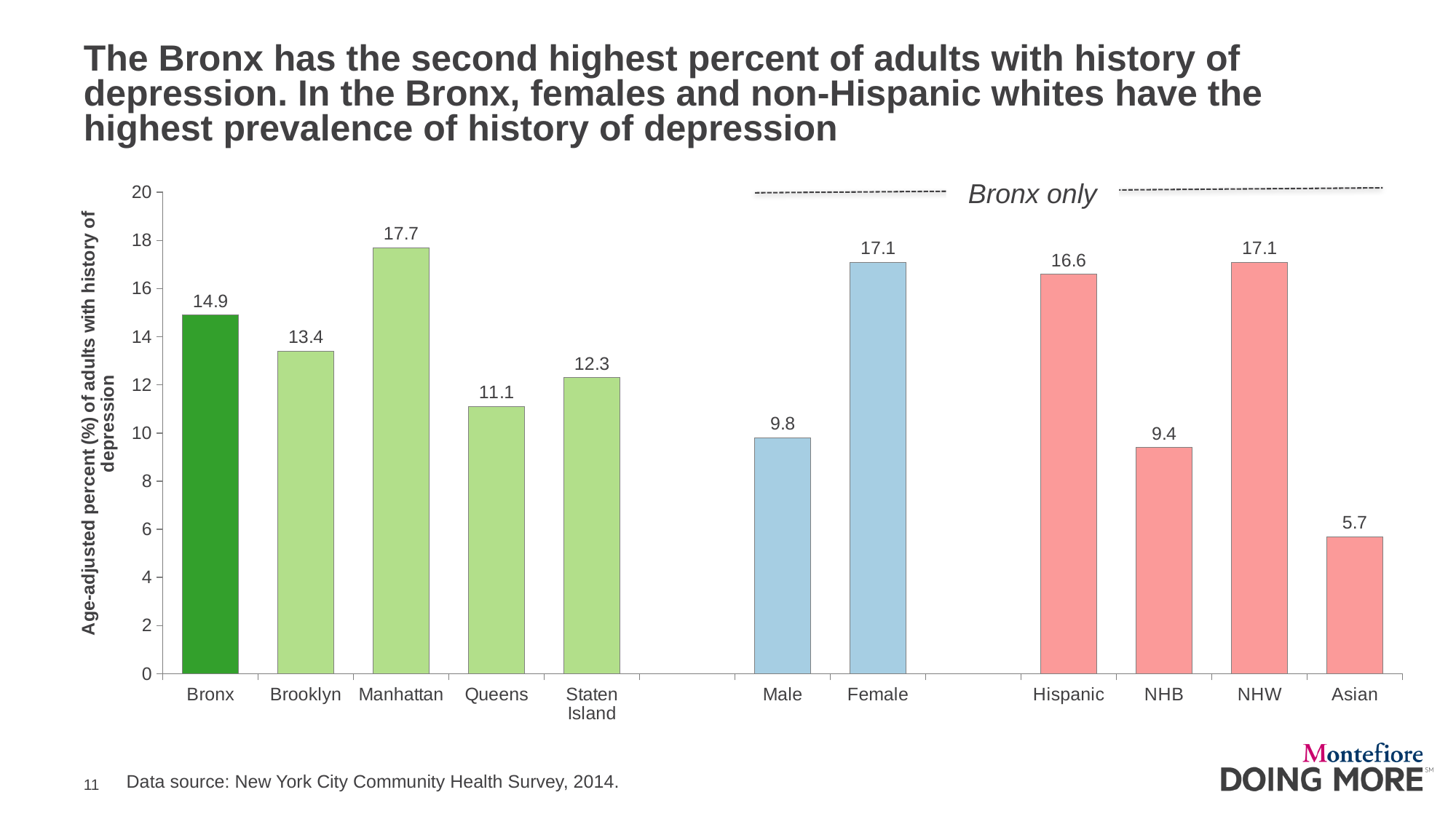
What is the difference between the Manhattan and Bronx values? 2.8 What is the value shown for Female in the Bronx-only section? 17.1 What is the age-adjusted percent of adults with history of depression in the Bronx? 14.9 Which borough has the highest percent of adults with history of depression? Manhattan What is the value shown for Manhattan? 17.7 What is the value shown for Asian? 5.7 How many bars are plotted on the chart? 11 What is the label on the vertical axis? Age-adjusted percent (%) of adults with history of depression Which is larger, the value for Hispanic or the value for NHB? Hispanic What is the difference between the Female and Male values? 7.3 What type of chart is shown on the slide? Bar chart Which category on the chart has the lowest value? Asian